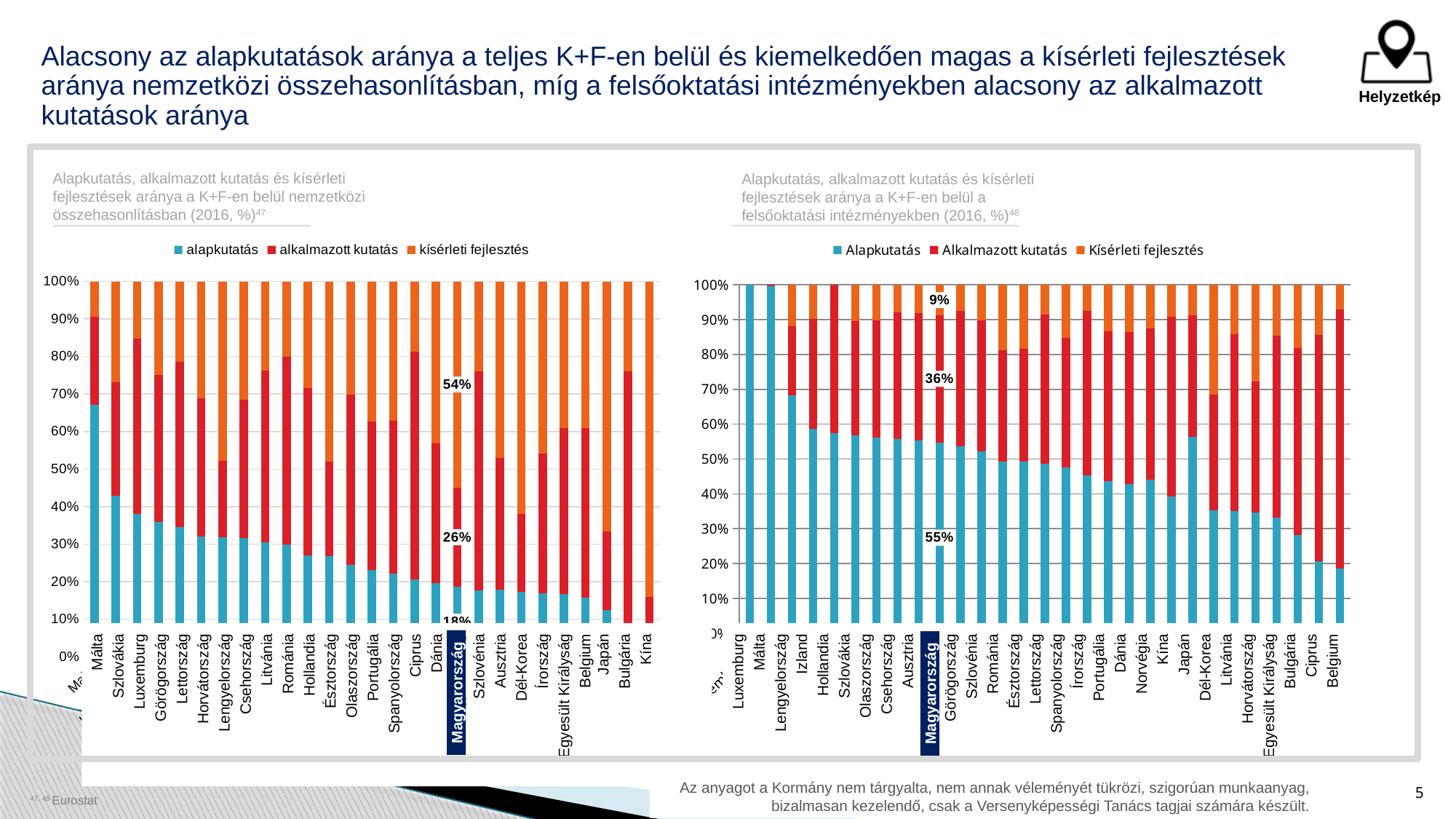
In the left chart (nemzetközi összehasonlításban), what is the share of alapkutatás for Magyarország? 18% In the left chart (nemzetközi összehasonlításban), what is the share of kísérleti fejlesztés for Magyarország? 54% How many percentage points higher is the kísérleti fejlesztés share for Magyarország in the left chart (54%) than in the right chart (9%)? 45 In the right chart (felsőoktatási intézményekben), what is the share of Kísérleti fejlesztés for Magyarország? 9% What kind of chart is the left chart (nemzetközi összehasonlításban)? stacked bar chart In the right chart (felsőoktatási intézményekben), what is the share of Alkalmazott kutatás for Magyarország? 36% In the left chart (nemzetközi összehasonlításban), which country has the highest alapkutatás share? Málta In the right chart (felsőoktatási intézményekben), is the Alapkutatás share for Belgium greater or less than 30%? less How many series does the legend of the left chart list? 3 Which is larger for Magyarország: the alapkutatás share in the left chart or the Alapkutatás share in the right chart? the right chart (55%) In the left chart (nemzetközi összehasonlításban), what is the share of alkalmazott kutatás for Magyarország? 26% In the right chart (felsőoktatási intézményekben), what is the share of Alapkutatás for Magyarország? 55%